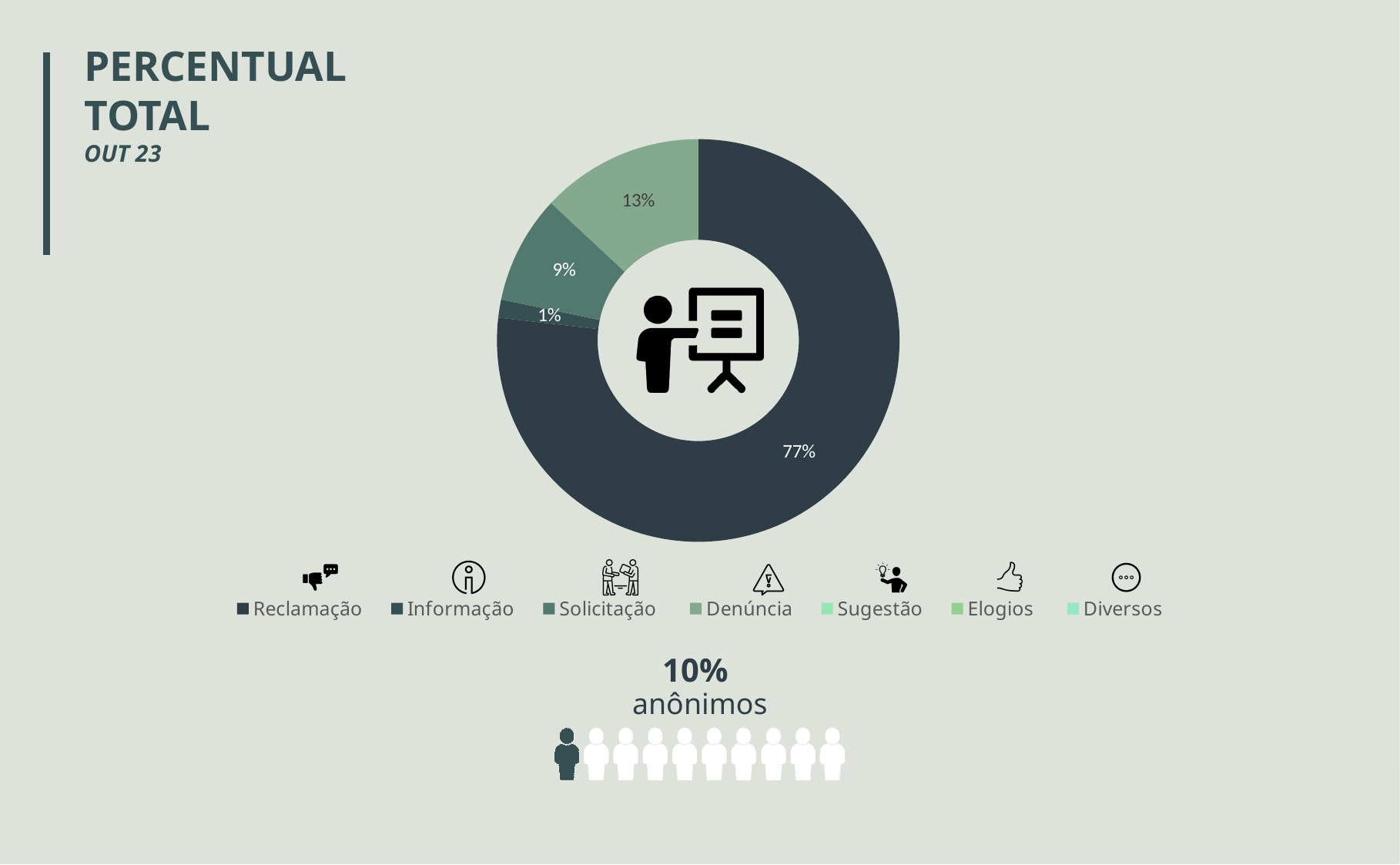
What percentage does the Informação slice show? 1% What percentage does the Solicitação slice show? 9% How many slices of the pie have a percentage label printed on them? 4 What percentage does the Denúncia slice show? 13% What is the difference in percentage points between the Denúncia slice and the Solicitação slice? 4 percentage points Which category has the largest slice of the pie? Reclamação What is the difference in percentage points between the Reclamação slice and the Denúncia slice? 64 percentage points What kind of chart is shown on the slide? doughnut chart Which is larger, the Denúncia slice or the Solicitação slice? Denúncia What is the title of the chart on the slide? PERCENTUAL TOTAL How many categories does the legend list? 7 What percentage does the Reclamação slice show? 77%